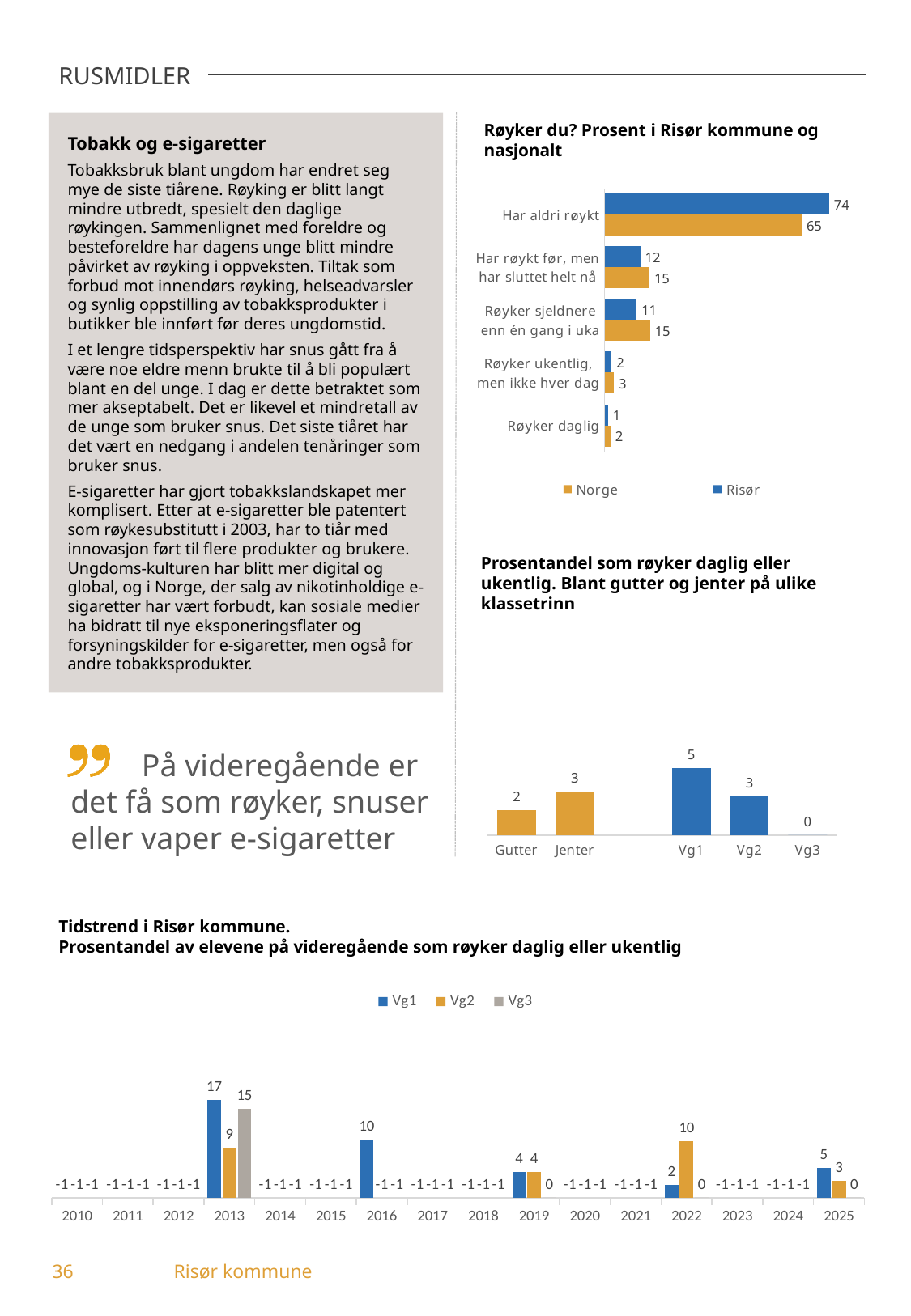
In the chart 'Tidstrend i Risør kommune', how many series does the legend list? 3 In the chart 'Røyker du? Prosent i Risør kommune og nasjonalt', what is the difference between Risør and Norge for 'Har aldri røykt'? 9 In the chart 'Røyker du? Prosent i Risør kommune og nasjonalt', what is the value for Norge in the category 'Røyker sjeldnere enn én gang i uka'? 15 In the chart 'Tidstrend i Risør kommune', what is the value for Vg2 in 2022? 10 In the chart 'Prosentandel som røyker daglig eller ukentlig', which is larger, the value for Gutter or the value for Jenter? Jenter In the chart 'Prosentandel som røyker daglig eller ukentlig', what is the value for Vg1? 5 In the chart 'Røyker du? Prosent i Risør kommune og nasjonalt', what is the value for Risør in the category 'Har aldri røykt'? 74 In the chart 'Tidstrend i Risør kommune', what is the difference between Vg1 and Vg2 in 2013? 8 In the chart 'Røyker du? Prosent i Risør kommune og nasjonalt', which category has the lowest value for Risør? Røyker daglig What kind of chart is 'Røyker du? Prosent i Risør kommune og nasjonalt'? Bar chart In the chart 'Prosentandel som røyker daglig eller ukentlig', which category has the highest value? Vg1 How many series does the legend list in the chart 'Røyker du? Prosent i Risør kommune og nasjonalt'? 2